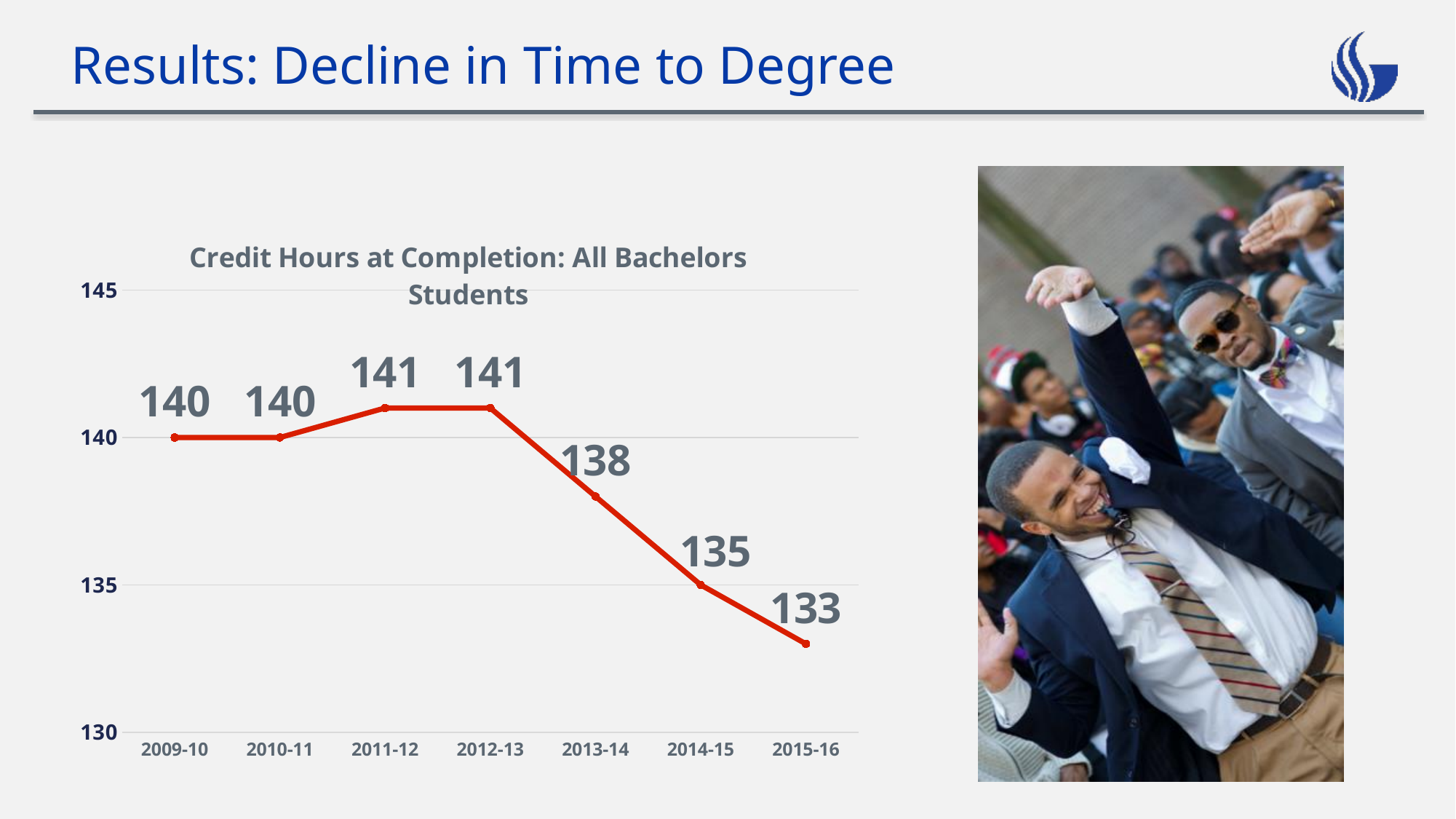
Which is larger, the value for 2011-12 or the value for 2014-15? 2011-12 Do the values rise or fall from 2012-13 to 2015-16? Fall What is the value for 2009-10? 140 What kind of chart is shown on the slide? Line chart Which year has the lowest value? 2015-16 What is the value for 2015-16? 133 What is the difference between the values for 2013-14 and 2014-15? 3 What is the title of the chart? Credit Hours at Completion: All Bachelors Students What is the difference between the values for 2012-13 and 2015-16? 8 What is the value for 2013-14? 138 How many data points are plotted on the chart? 7 What is the value for 2014-15? 135